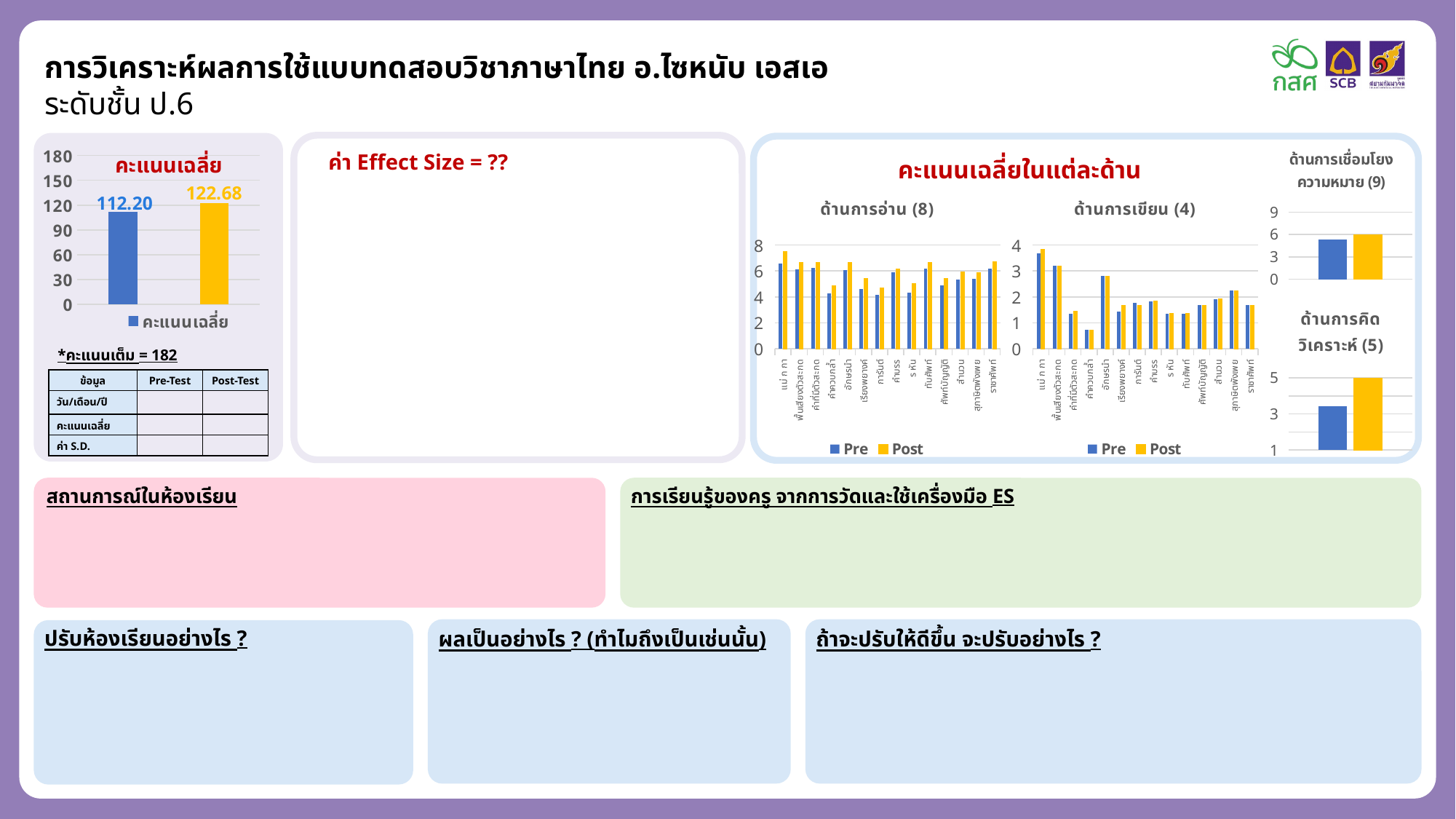
What is the title of the panel on the right that contains the reading and writing charts? คะแนนเฉลี่ยในแต่ละด้าน In the chart titled คะแนนเฉลี่ย, what is the value shown on the blue (first) bar? 112.20 In the chart titled คะแนนเฉลี่ย, what is the difference between the yellow bar and the blue bar? 10.48 In the chart titled ด้านการเชื่อมโยงความหมาย (9), is the yellow (Post) bar greater or less than 3? greater In the chart titled คะแนนเฉลี่ย, which bar is taller, the blue one or the yellow one? the yellow one In the chart titled ด้านการเขียน (4), is the Pre value for คำควบกล้ำ greater or less than 1? less In the chart titled ด้านการอ่าน (8), how many categories are shown on the x axis? 14 In the chart titled ด้านการเขียน (4), how many series does the legend list? 2 In the chart titled ด้านการอ่าน (8), is the Post value for แม่ ก กา greater or less than 6? greater What kind of chart is the chart titled คะแนนเฉลี่ย? bar chart In the chart titled คะแนนเฉลี่ย, what is the value shown on the yellow (second) bar? 122.68